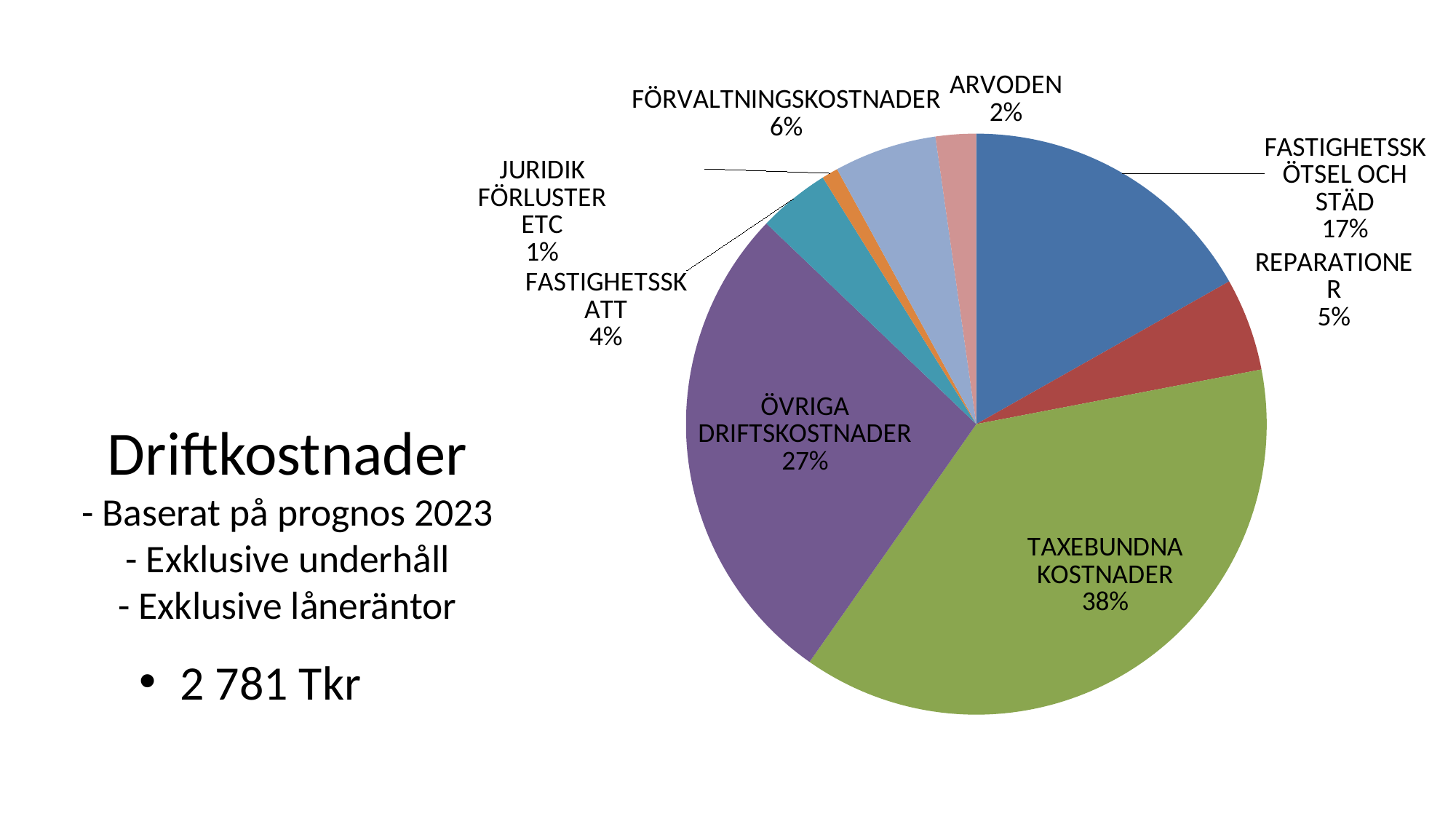
How many slices does the pie chart have? 8 What percentage is shown for FÖRVALTNINGSKOSTNADER? 6% What total amount in Tkr is stated on the slide next to the chart? 2 781 Tkr What percentage is shown for ARVODEN? 2% What share of the pie is TAXEBUNDNA KOSTNADER? 38% Which is larger, REPARATIONER or FASTIGHETSSKATT? REPARATIONER Which category has the largest slice of the pie? TAXEBUNDNA KOSTNADER What share of the pie is ÖVRIGA DRIFTSKOSTNADER? 27% What percentage is shown for FASTIGHETSSKÖTSEL OCH STÄD? 17% What kind of chart is shown on the slide? Pie chart What is the difference in percentage points between TAXEBUNDNA KOSTNADER and ÖVRIGA DRIFTSKOSTNADER? 11 Which category has the smallest slice of the pie? JURIDIK FÖRLUSTER ETC